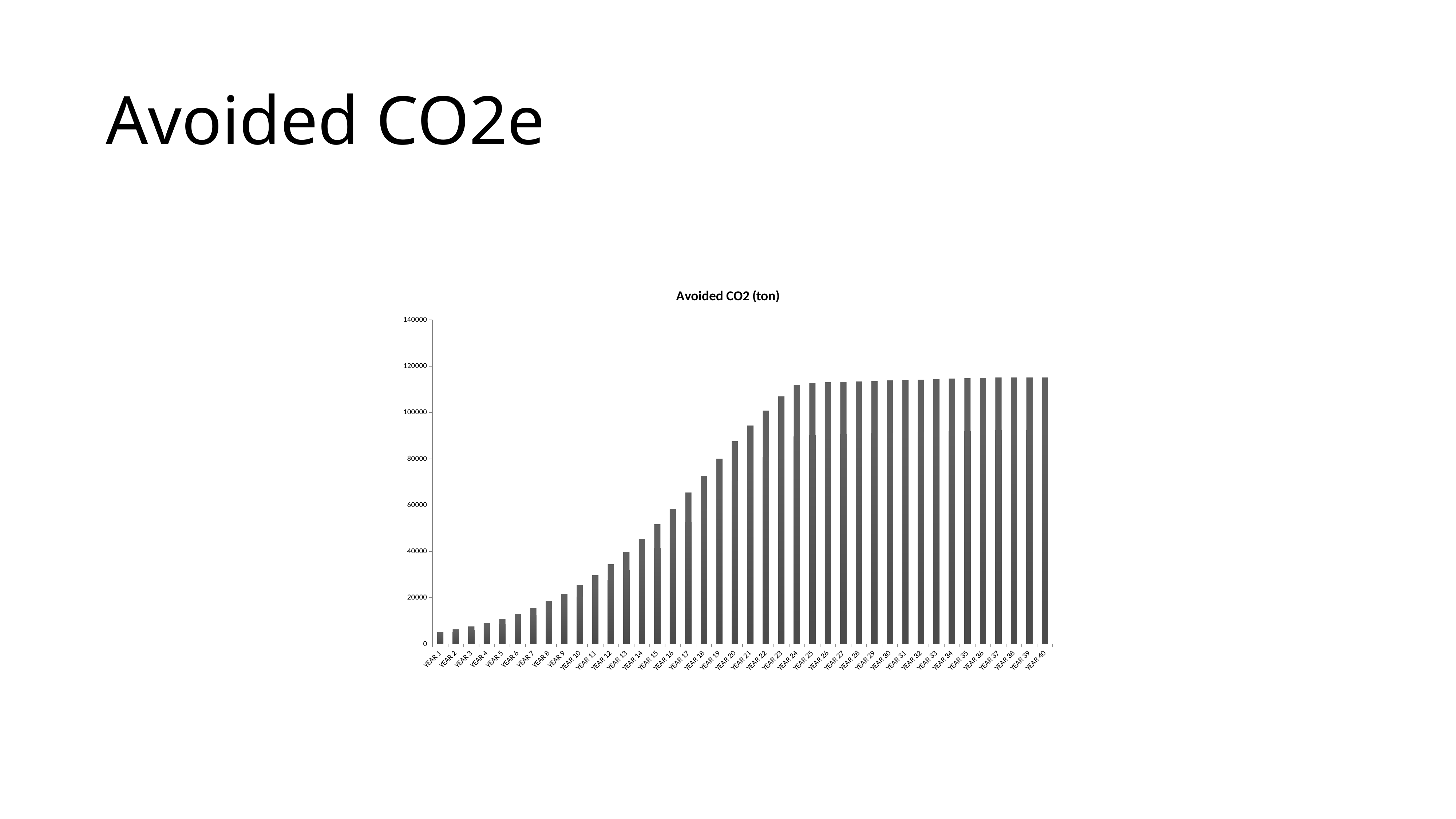
What is the title of the chart? Avoided CO2 (ton) How many years (categories) are plotted on the x axis? 40 Is the value for YEAR 20 greater or less than 80000? greater Which year has the lowest avoided CO2 value? YEAR 1 How do the values change from YEAR 1 to YEAR 40? They rise steadily and then level off from about YEAR 24 onward Is the value for YEAR 35 greater or less than 100000? greater Is the value for YEAR 15 greater or less than 40000? greater What kind of chart is shown on the slide? Bar chart Which is larger, the value for YEAR 5 or the value for YEAR 25? YEAR 25 Which is larger, the value for YEAR 10 or the value for YEAR 20? YEAR 20